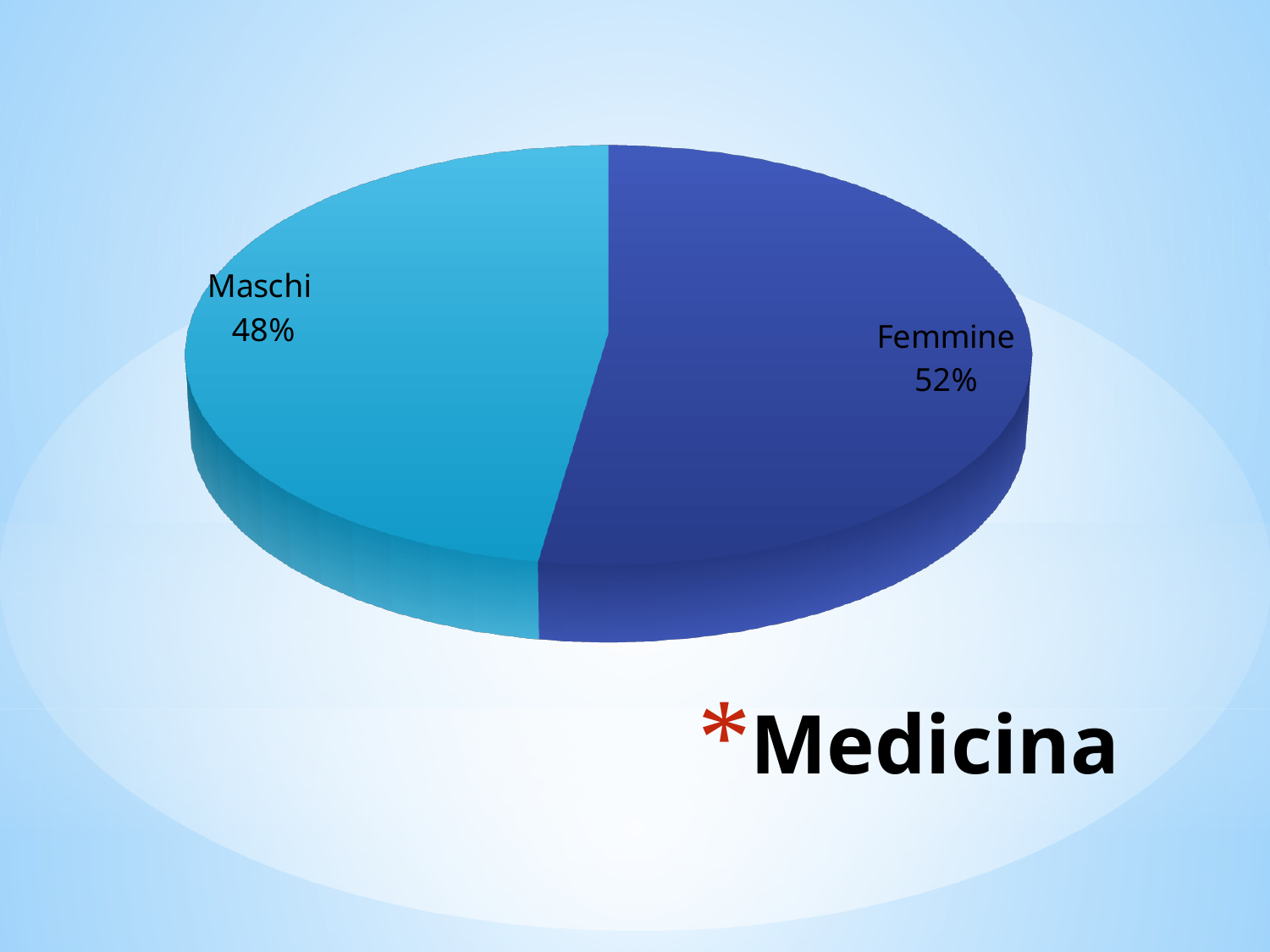
What is the difference in percentage points between the Femmine and Maschi slices? 4 Which slice is larger, Maschi or Femmine? Femmine What share of the pie does the Maschi slice represent? 48% How many slices does the pie chart have? 2 What word appears as the text label below the pie chart? Medicina What kind of chart is shown on the slide? Pie chart Which slice of the pie chart is the smallest? Maschi Which slice of the pie chart is the largest? Femmine What percentage of the pie chart is labelled Maschi? 48% What percentage of the pie chart is labelled Femmine? 52% What colour is the Femmine slice of the pie chart? Dark blue What is the total of the two slices shown in the pie chart? 100%